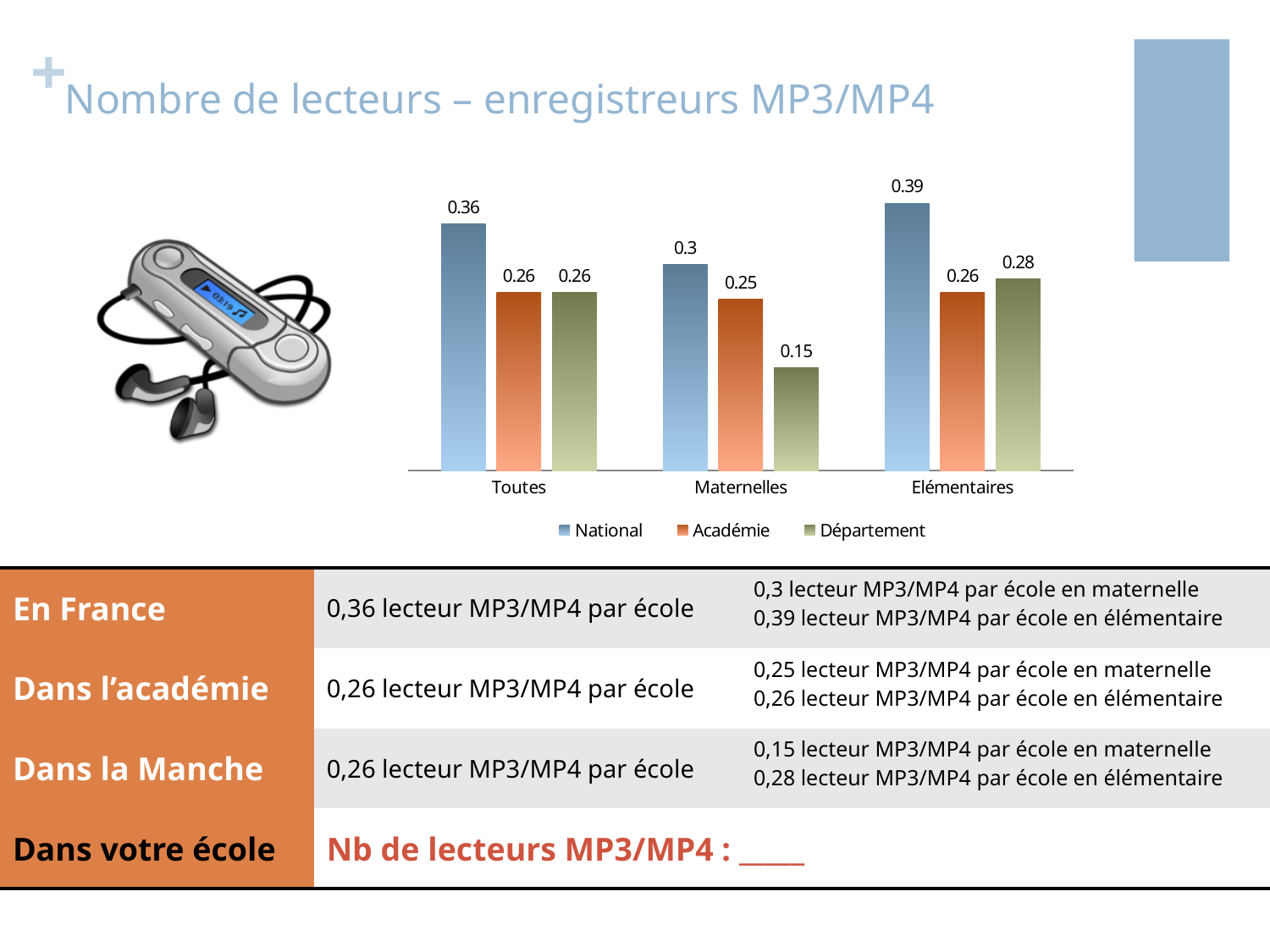
Which category has the highest National value? Elémentaires What is the difference between the National and Département values for Maternelles? 0.15 What is the National value for Elémentaires? 0.39 What is the Académie value for Toutes? 0.26 What kind of chart is shown on the slide? Bar chart How many series does the legend list? 3 Which category has the lowest Département value? Maternelles What is the Département value for Maternelles? 0.15 Which is larger for Elémentaires: the Académie value or the Département value? Département How many categories are shown on the x axis? 3 What is the difference between the National values for Elémentaires and Toutes? 0.03 Which series is shown in orange in the legend? Académie